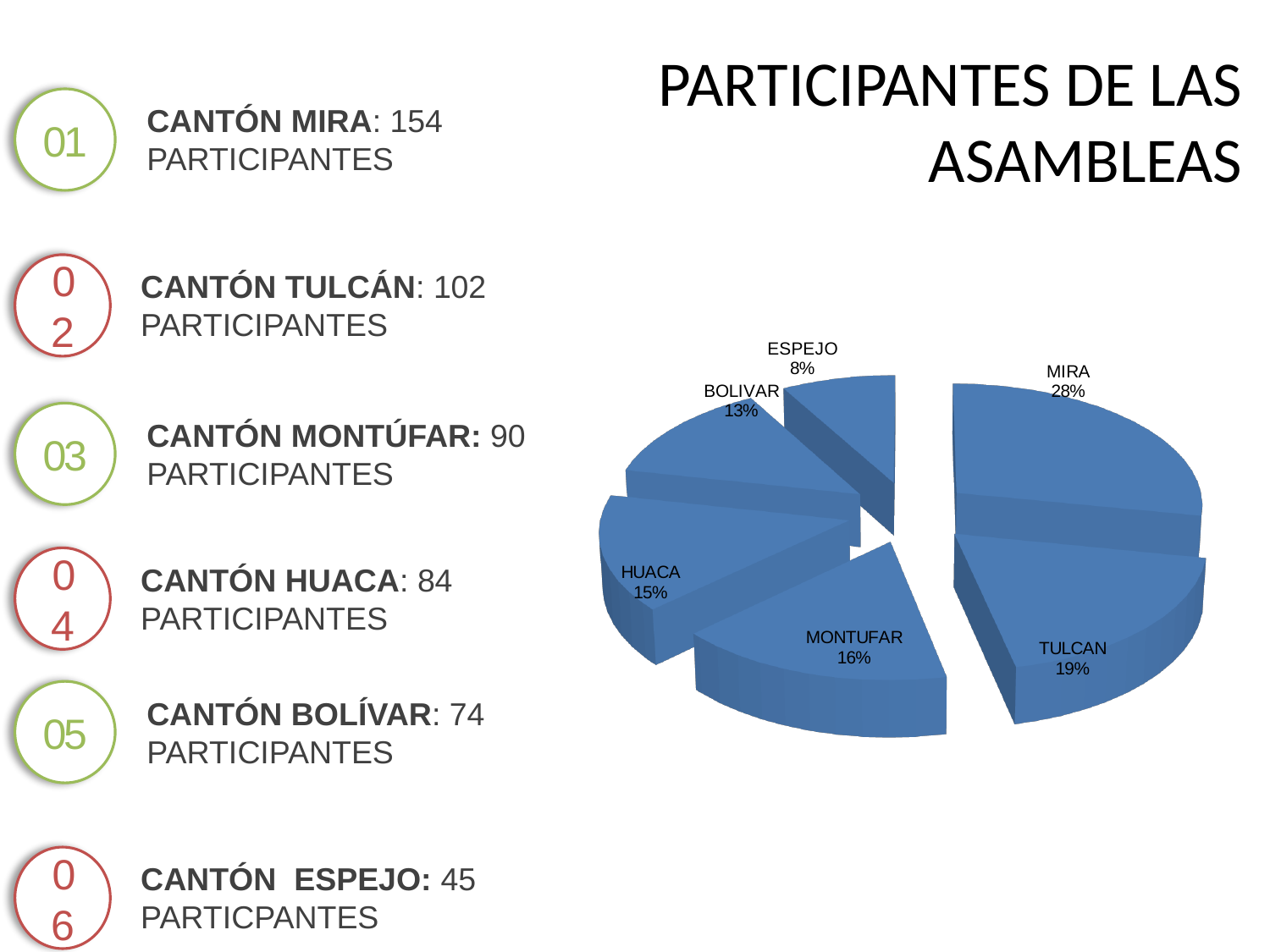
Which slice is larger, MONTUFAR or BOLIVAR? MONTUFAR What kind of chart is shown on the slide? pie chart What share of the pie does TULCAN represent? 19% Which slice of the pie chart is the smallest? ESPEJO What share of the pie does ESPEJO represent? 8% What share of the pie does HUACA represent? 15% What is the difference in percentage points between the HUACA and ESPEJO slices? 7% What is the difference in percentage points between the MIRA and TULCAN slices? 9% Which slice of the pie chart is the largest? MIRA How many slices does the pie chart have? 6 What is the title of the chart on the slide? PARTICIPANTES DE LAS ASAMBLEAS